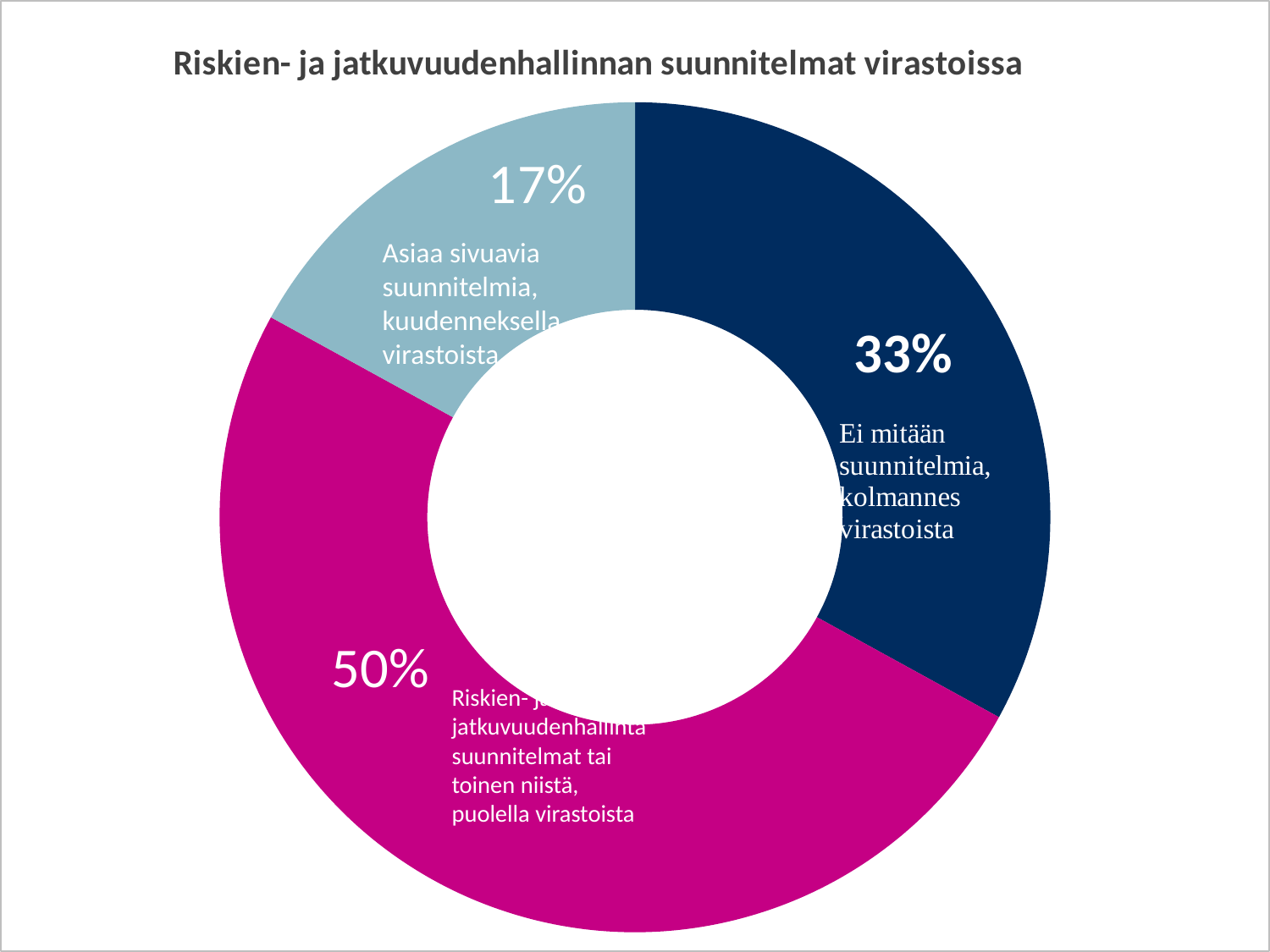
What share of the chart is labelled "Riskien- ja jatkuvuudenhallinta suunnitelmat tai toinen niistä, puolella virastoista"? 50% Which slice is the largest? Riskien- ja jatkuvuudenhallinta suunnitelmat tai toinen niistä, puolella virastoista (50%) What is the difference in percentage points between the 33% slice and the 17% slice? 16 Which slice is the smallest? Asiaa sivuavia suunnitelmia, kuudenneksella virastoista (17%) What share of the chart is labelled "Asiaa sivuavia suunnitelmia, kuudenneksella virastoista"? 17% How many slices does the chart have? 3 Which is larger: the slice for "Ei mitään suunnitelmia" or the slice for "Asiaa sivuavia suunnitelmia"? Ei mitään suunnitelmia (33%) What is the difference in percentage points between the 50% slice and the 33% slice? 17 What is the title of the chart? Riskien- ja jatkuvuudenhallinnan suunnitelmat virastoissa What share of the chart is labelled "Ei mitään suunnitelmia, kolmannes virastoista"? 33% What colour is the 50% slice? Magenta What kind of chart is shown on the slide? Pie chart (donut)